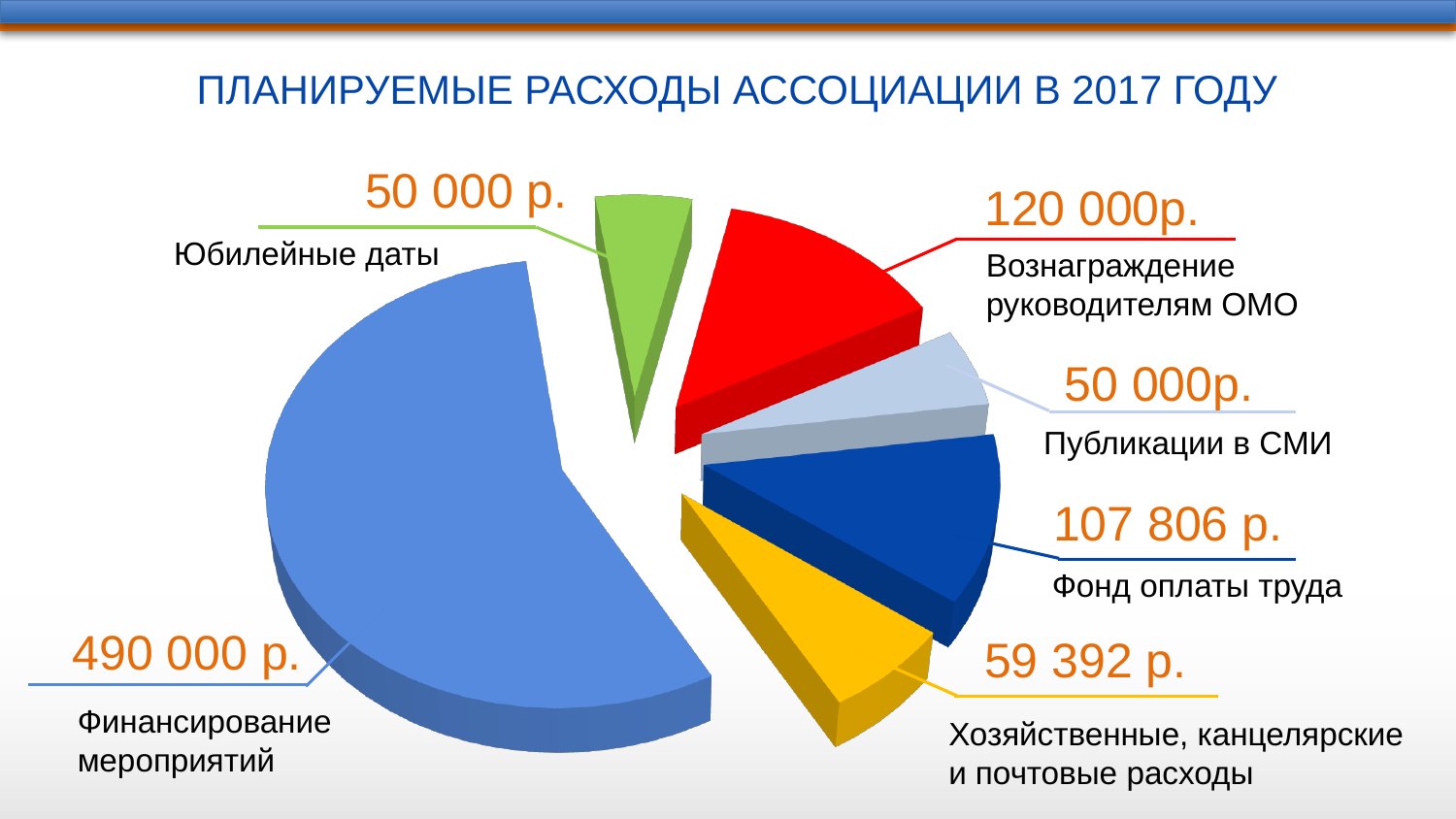
What type of chart is shown on the slide? Pie chart Which category has the largest planned expense? Финансирование мероприятий What is the planned amount for Вознаграждение руководителям ОМО? 120 000р. What is the title of the chart? ПЛАНИРУЕМЫЕ РАСХОДЫ АССОЦИАЦИИ В 2017 ГОДУ What is the planned amount for Публикации в СМИ? 50 000р. What is the planned amount for Хозяйственные, канцелярские и почтовые расходы? 59 392 р. What is the difference between Вознаграждение руководителям ОМО and Фонд оплаты труда? 12 194 р. What is the planned amount for Финансирование мероприятий? 490 000 р. What colour is the slice for Юбилейные даты? Green How many slices does the pie chart have? 6 Which is larger: Фонд оплаты труда or Вознаграждение руководителям ОМО? Вознаграждение руководителям ОМО What is the planned amount for Фонд оплаты труда? 107 806 р.